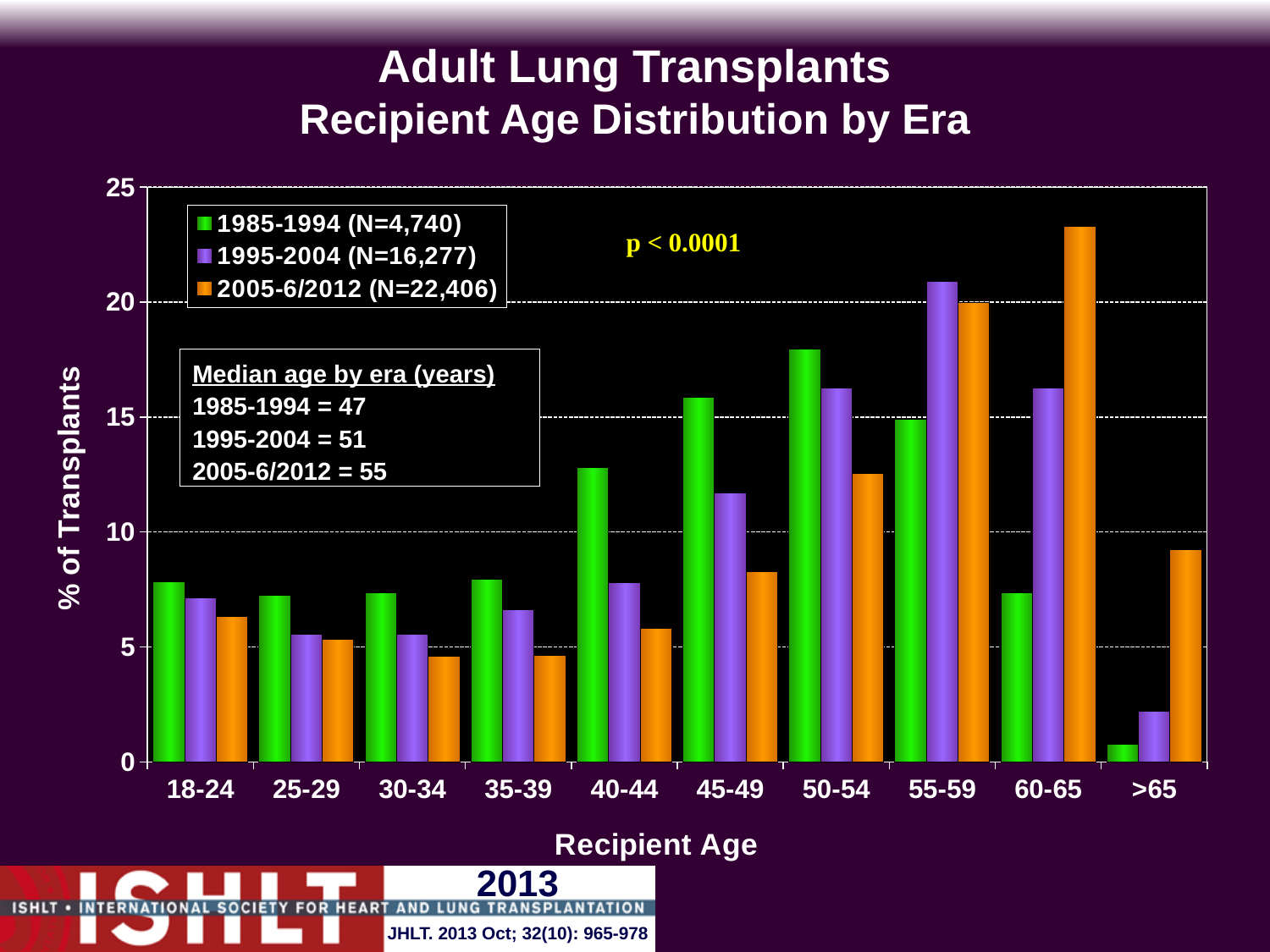
Is the value for the 2005-6/2012 era in the 60-65 age group greater or less than 20? greater For the 2005-6/2012 era, which recipient age group has the highest percentage of transplants? 60-65 In the 45-49 age group, which era has the larger percentage of transplants: 1985-1994 or 2005-6/2012? 1985-1994 How many recipient age groups are shown on the x axis? 10 What kind of chart is shown on the slide? bar chart How many series does the legend list? 3 Is the value for the 1985-1994 era in the 40-44 age group greater or less than 10? greater According to the legend, what is the N for the 1995-2004 era? 16,277 Is the value for the 1995-2004 era in the >65 age group greater or less than 5? less For the 1985-1994 era, which recipient age group has the lowest percentage of transplants? >65 For the 1985-1994 era, which recipient age group has the highest percentage of transplants? 50-54 For the 1995-2004 era, which recipient age group has the highest percentage of transplants? 55-59